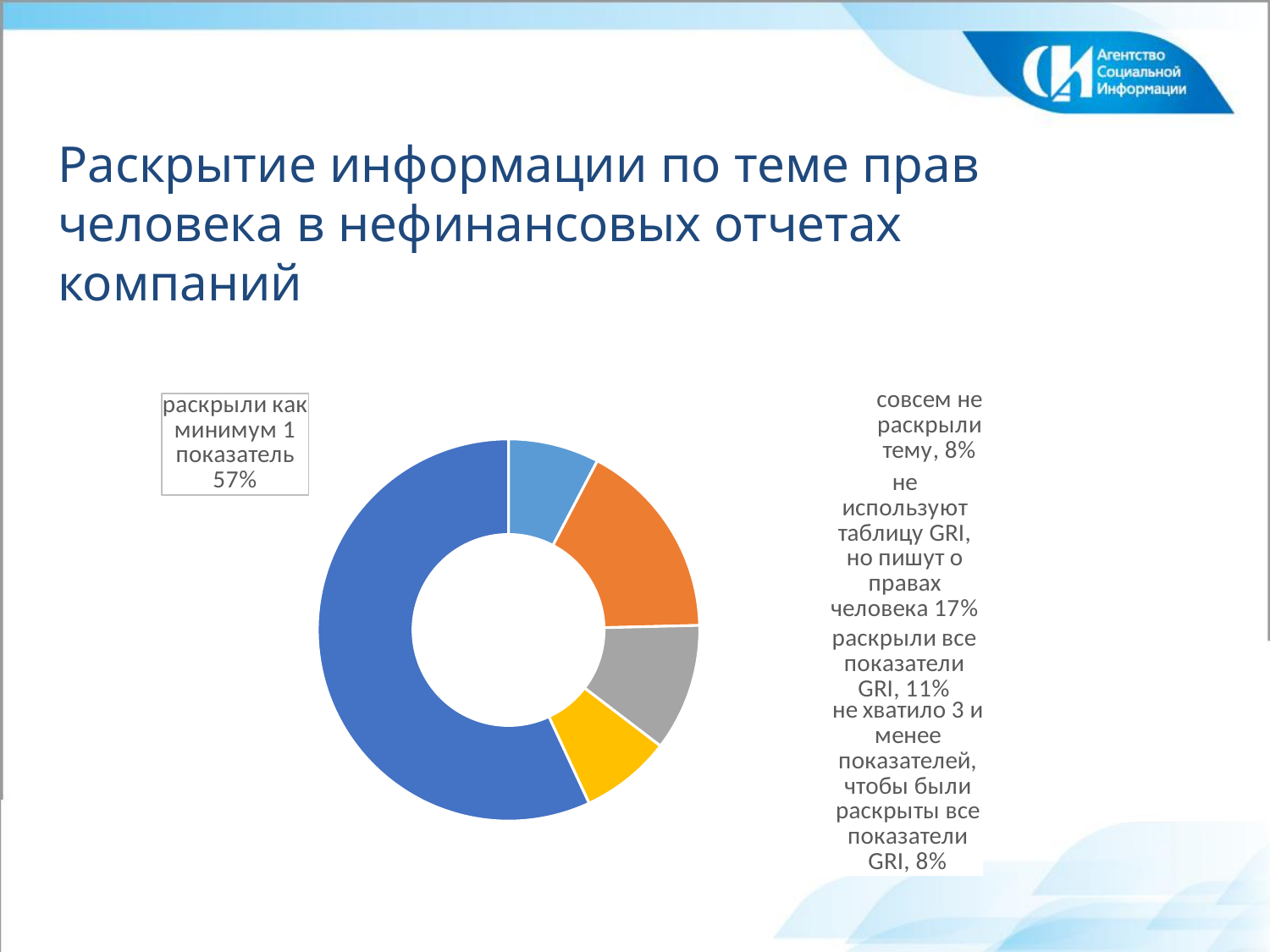
What colour is the slice for 'раскрыли как минимум 1 показатель'? dark blue What kind of chart is shown on the slide? doughnut (pie) chart Which is larger: the share that does not use the GRI table but writes about human rights, or the share that disclosed all GRI indicators? не используют таблицу GRI, но пишут о правах человека What is the difference in percentage points between 'раскрыли все показатели GRI' and 'совсем не раскрыли тему'? 3 percentage points What is the difference in percentage points between 'раскрыли как минимум 1 показатель' and 'не используют таблицу GRI, но пишут о правах человека'? 40 percentage points What share of companies did not disclose the topic at all (совсем не раскрыли тему)? 8% What share of companies do not use the GRI table but write about human rights? 17% What share of companies disclosed at least one indicator (раскрыли как минимум 1 показатель)? 57% How many slices does the chart have? 5 What share of companies lacked 3 or fewer indicators to have all GRI indicators disclosed? 8% Which category has the largest share in the chart? раскрыли как минимум 1 показатель What share of companies disclosed all GRI indicators (раскрыли все показатели GRI)? 11%